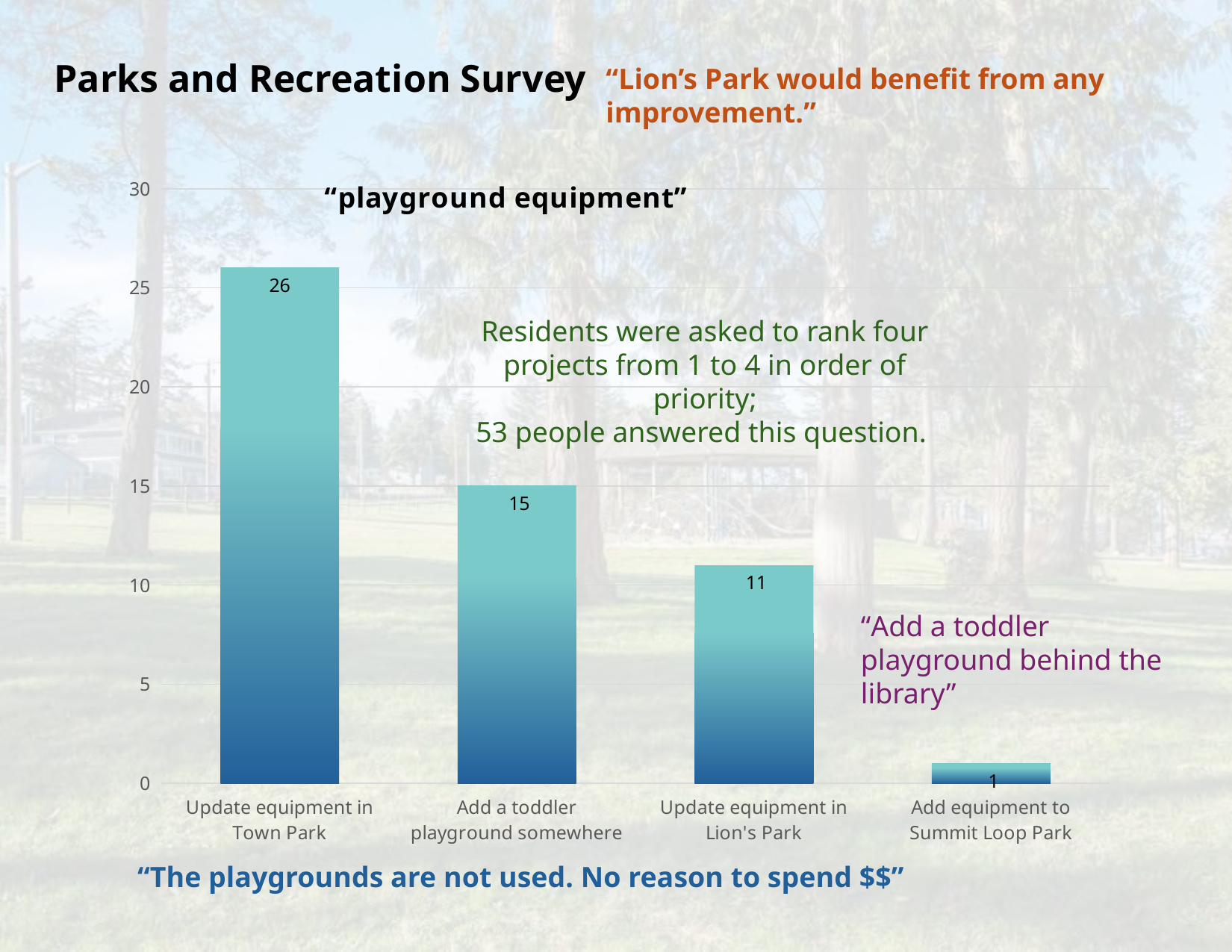
What is the value for "Update equipment in Lion's Park"? 11 Do the values rise or fall from left to right along the x axis? fall How many categories are shown on the chart? 4 What is the difference between the values for "Update equipment in Town Park" and "Add a toddler playground somewhere"? 11 Which category has the lowest value? Add equipment to Summit Loop Park Which category has the highest value? Update equipment in Town Park What is the value for "Update equipment in Town Park"? 26 What kind of chart is shown on the slide? bar chart Which is larger, the value for "Update equipment in Lion's Park" or "Add a toddler playground somewhere"? Add a toddler playground somewhere Is the value for "Update equipment in Town Park" greater or less than 25? greater What is the value for "Add equipment to Summit Loop Park"? 1 What is the value for "Add a toddler playground somewhere"? 15